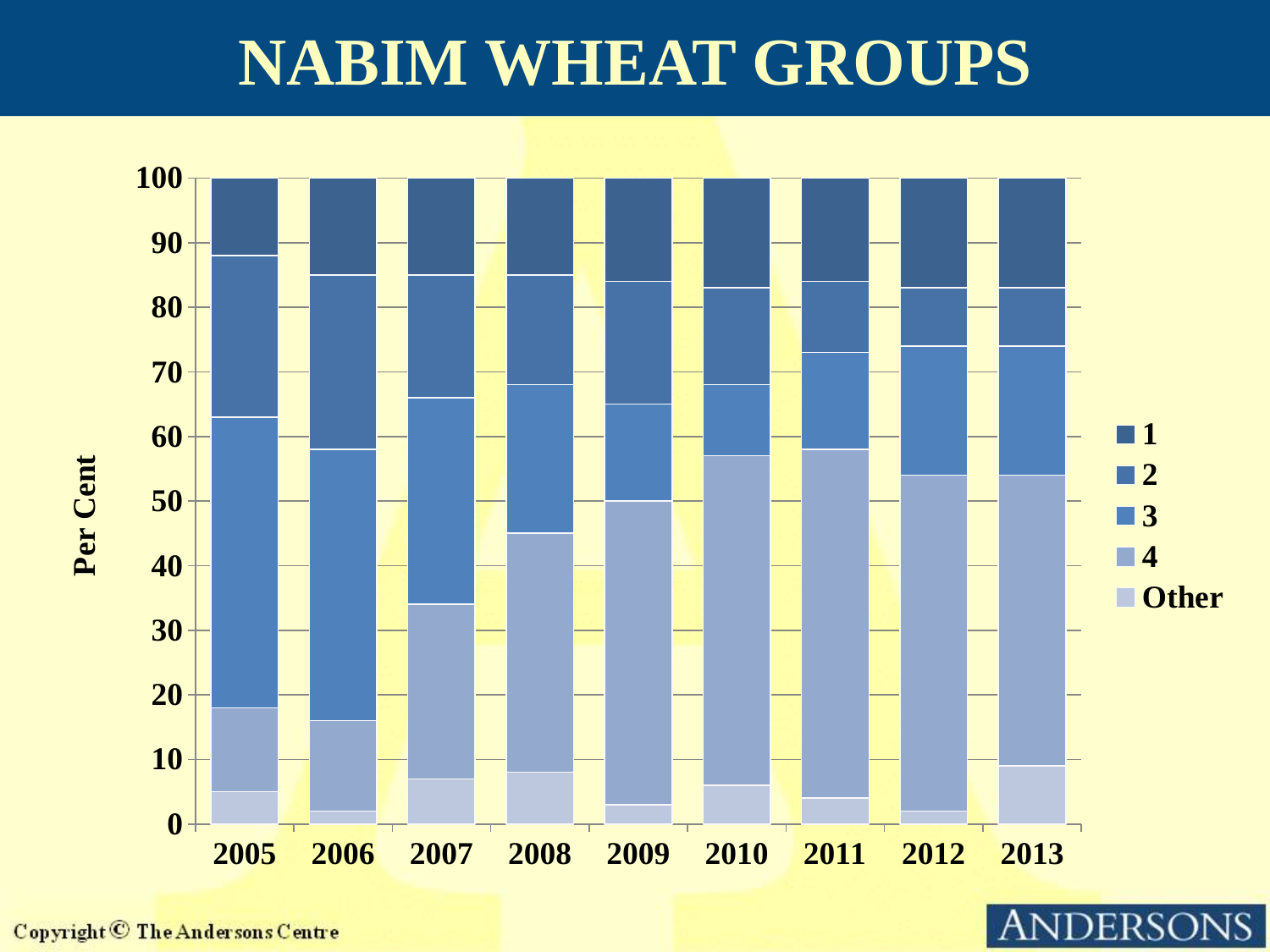
Is the share of group 4 in 2011 greater or less than 40? greater What is the label on the vertical axis? Per Cent Is the share of group 2 in 2012 greater or less than 20? less Is the share of group 4 in 2005 greater or less than 20? less What is the total height of the stacked bar for 2009? 100 Does the share of group 4 generally rise or fall from 2005 to 2011? rise How many years are shown on the x axis? 9 What type of chart is shown on the slide? Stacked bar chart How many series does the legend list? 5 What is the title of the chart? NABIM WHEAT GROUPS Which year has the larger share for group 3, 2005 or 2013? 2005